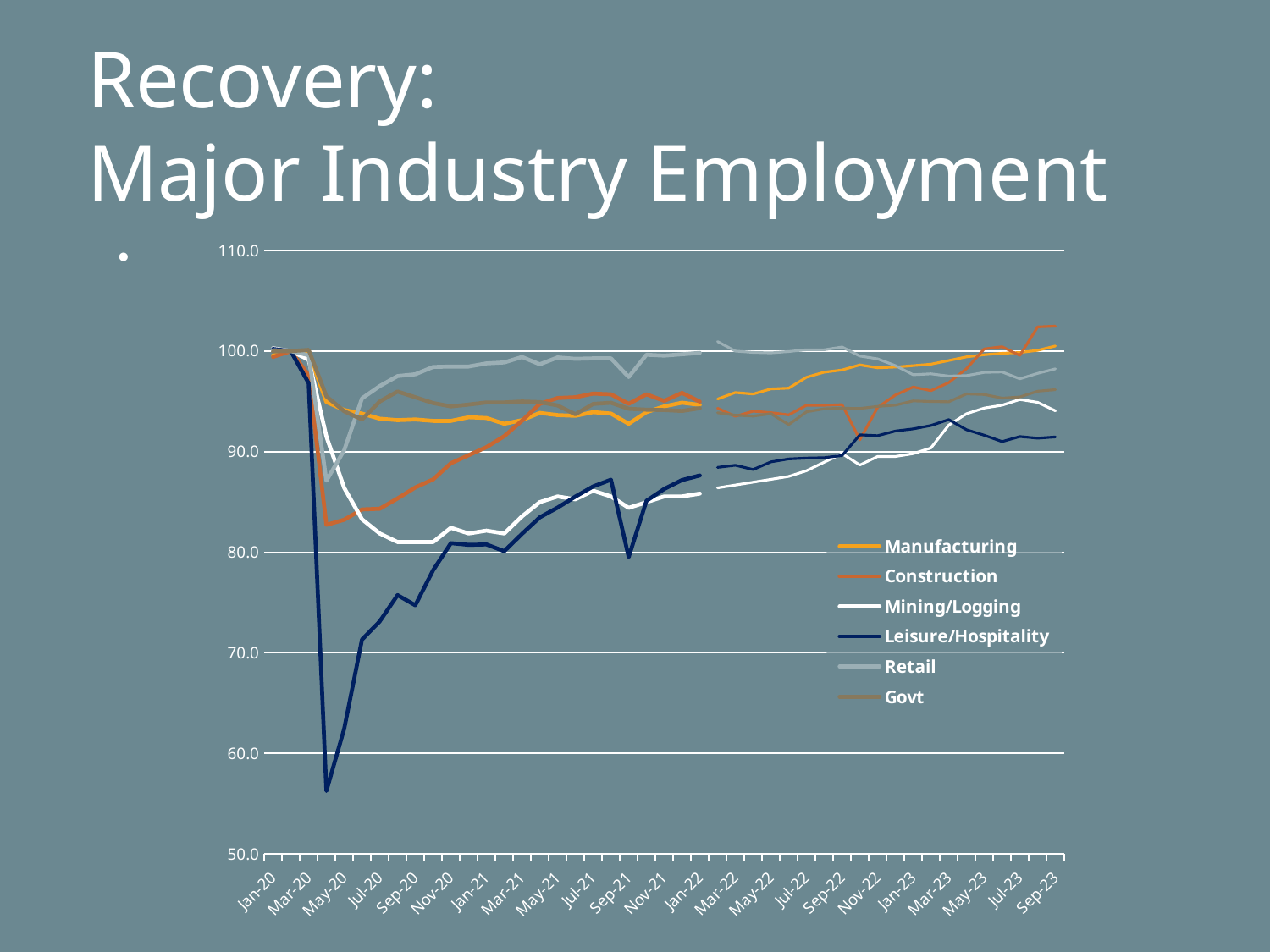
Which series falls to the lowest value in April 2020? Leisure/Hospitality In Apr-20, which is lower: Construction or Mining/Logging? Construction Is the value for Retail in Sep-23 greater or less than 90.0? greater Is the value for Construction in Sep-23 greater or less than 100.0? greater What kind of chart is shown on the slide? Line chart Does the Leisure/Hospitality line generally rise or fall from Apr-20 to Sep-23? Rise Which series has the highest value at Sep-23? Construction Is the value for Mining/Logging in Sep-20 greater or less than 90.0? less What is the title of the slide containing the chart? Recovery: Major Industry Employment Which series are listed in the legend? Manufacturing, Construction, Mining/Logging, Leisure/Hospitality, Retail, Govt How many series does the legend list? 6